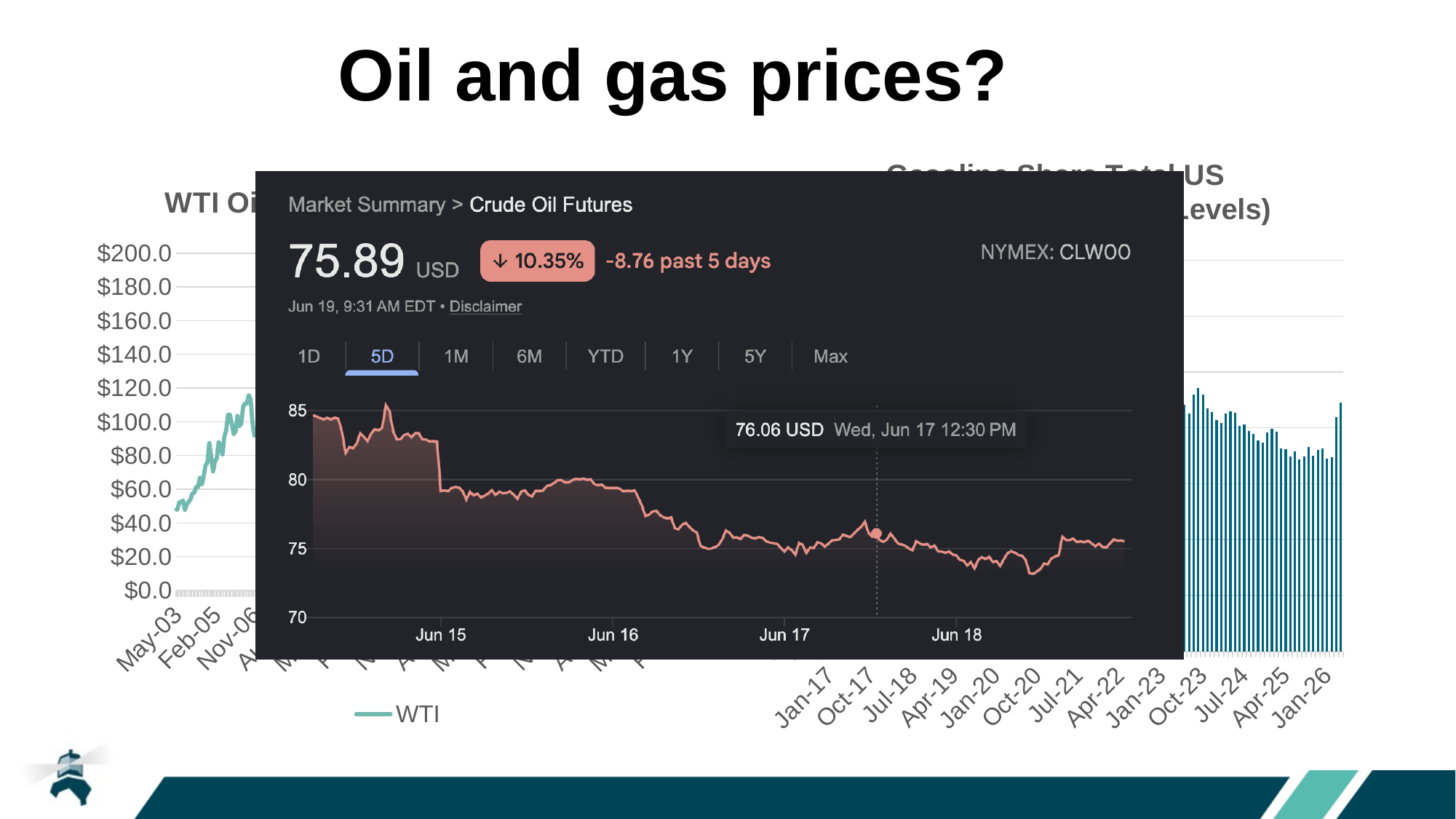
On the Crude Oil Futures chart, what price does the tooltip show for Wed, Jun 17 12:30 PM? 76.06 USD On the Crude Oil Futures chart, is the price at the very start of the line greater or less than 80? greater What kind of chart is the WTI chart on the left of the slide? line chart On the Crude Oil Futures chart, how many date labels are shown on the x axis? 4 On the Crude Oil Futures chart, what exchange and ticker are shown in the top right? NYMEX: CLW00 On the Crude Oil Futures chart, which time range tab is selected? 5D What kind of chart is the chart on the right of the slide? bar chart On the Crude Oil Futures chart, is the lowest point of the line greater or less than 75? less On the Crude Oil Futures chart, what is the current price shown? 75.89 USD On the Crude Oil Futures chart, what is the change over the past 5 days? -8.76 On the Crude Oil Futures chart, what percentage change is shown in the red badge? 10.35% down On the Crude Oil Futures chart, does the price generally rise or fall from Jun 15 to Jun 18? fall